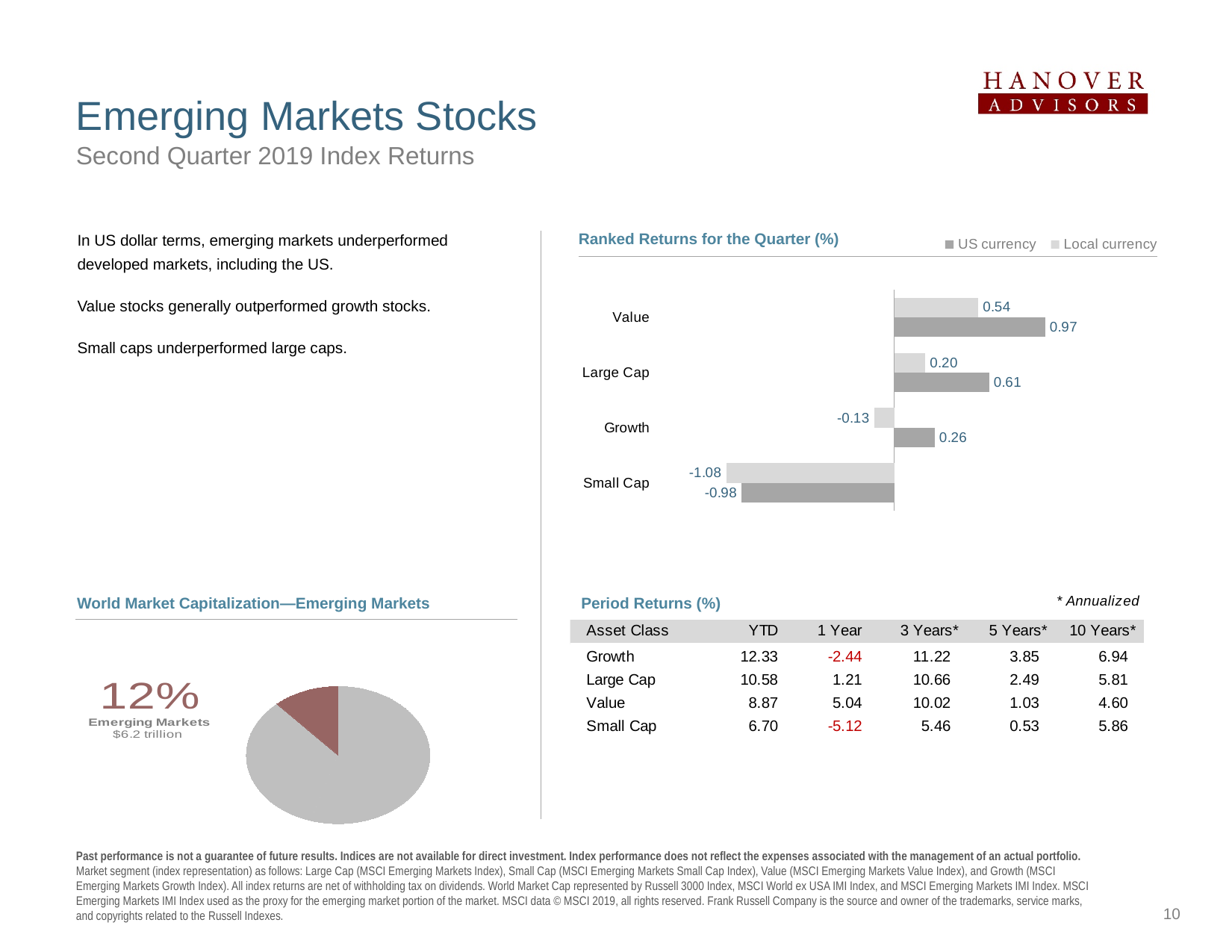
In the Ranked Returns for the Quarter (%) chart, what is the difference between the US currency and Local currency values for Value? 0.43 In the Ranked Returns for the Quarter (%) chart, what is the Local currency value for Small Cap? -1.08 How many categories are shown in the Ranked Returns for the Quarter (%) chart? 4 In the Ranked Returns for the Quarter (%) chart, what is the Local currency value for Large Cap? 0.20 What kind of chart is the World Market Capitalization—Emerging Markets chart? pie chart What kind of chart is the Ranked Returns for the Quarter (%) chart? bar chart In the Ranked Returns for the Quarter (%) chart, which category has the lowest Local currency value? Small Cap In the Ranked Returns for the Quarter (%) chart, which category has the highest US currency value? Value How many series does the legend of the Ranked Returns for the Quarter (%) chart list? 2 In the Ranked Returns for the Quarter (%) chart, what is the US currency value for Value? 0.97 In the Ranked Returns for the Quarter (%) chart, is the US currency value for Growth larger or smaller than the Local currency value for Growth? larger In the World Market Capitalization—Emerging Markets chart, what share of the pie do Emerging Markets represent? 12%